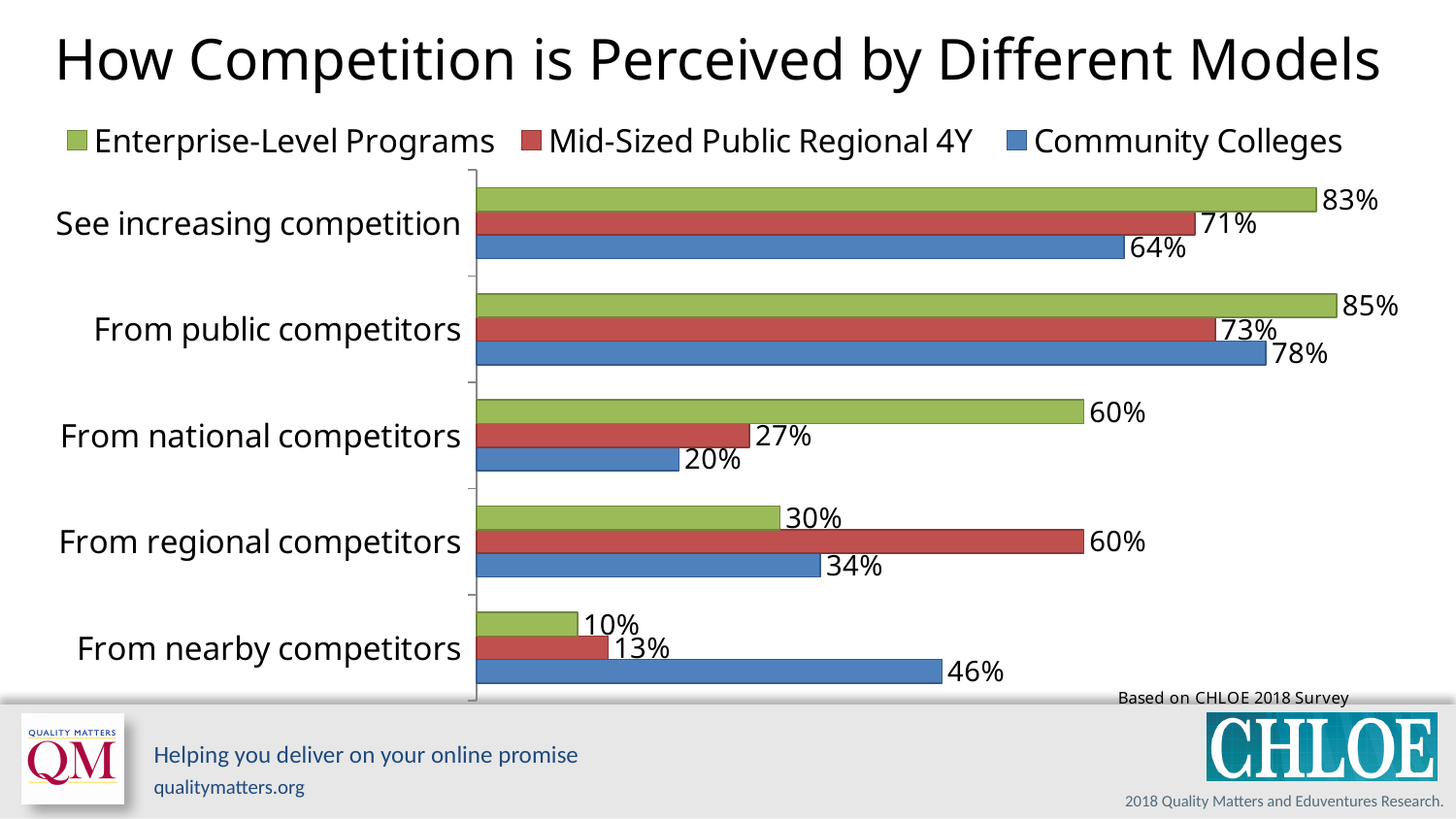
Which category has the lowest value for Enterprise-Level Programs? From nearby competitors How many series does the legend list? 3 What kind of chart is shown on the slide? Bar chart For 'From public competitors', which is larger: Mid-Sized Public Regional 4Y or Community Colleges? Community Colleges Which category has the highest value for Community Colleges? From public competitors How many categories are shown on the chart? 5 Which colour represents Community Colleges in the chart? Blue What is the title of the chart? How Competition is Perceived by Different Models What is the value for Mid-Sized Public Regional 4Y for 'From regional competitors'? 60% What percentage of Enterprise-Level Programs see increasing competition? 83% What is the difference between Enterprise-Level Programs and Community Colleges for 'From national competitors'? 40% What is the value for Community Colleges for 'From nearby competitors'? 46%